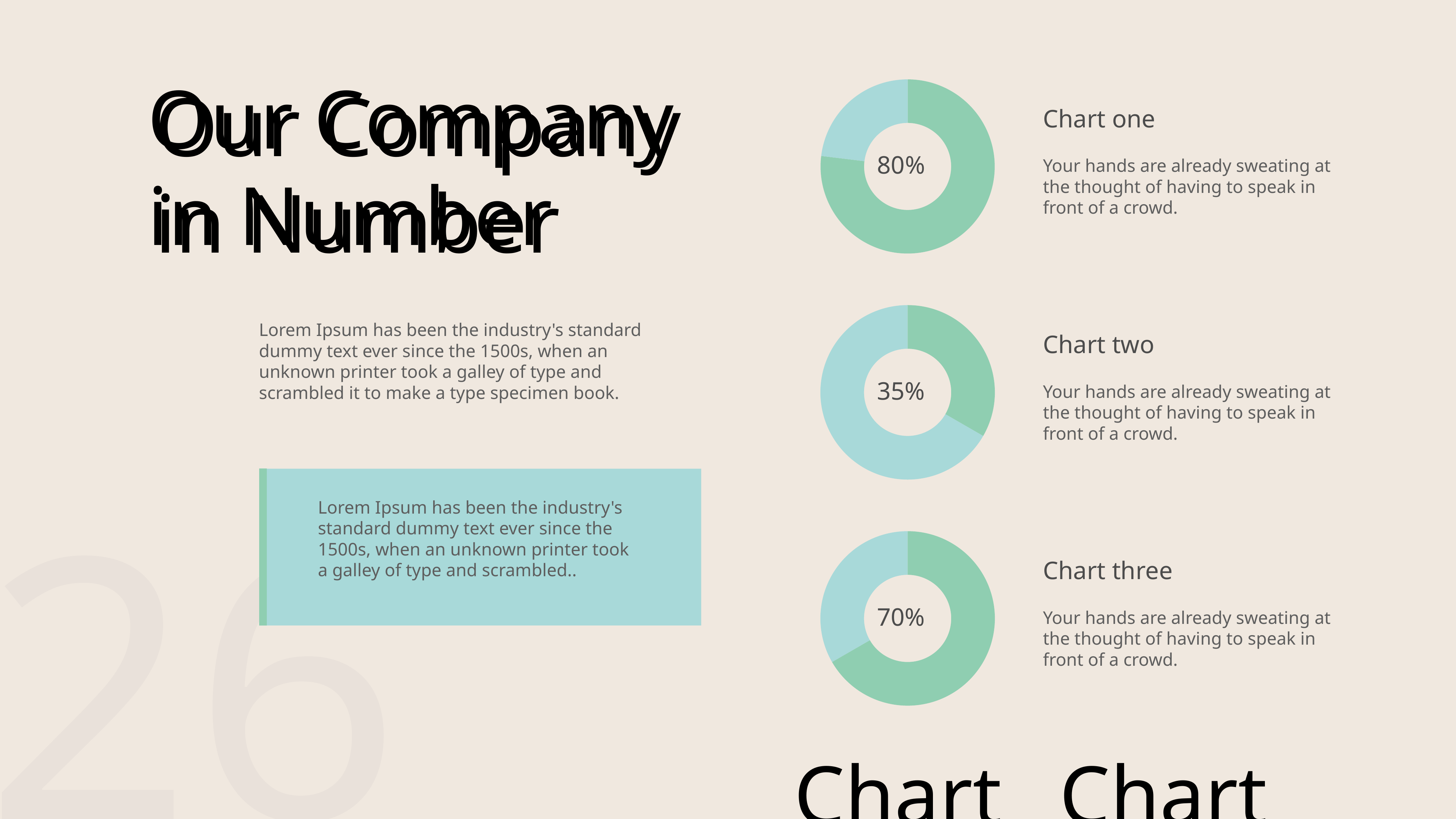
What percentage is shown in the centre of the donut chart labelled Chart two? 35% Which shows a larger percentage, Chart two or Chart three? Chart three Which of the three donut charts shows the highest percentage? Chart one How many donut charts are on the slide? 3 What is the difference between the percentage shown for Chart one and the percentage shown for Chart two? 45% What percentage is shown in the centre of the donut chart labelled Chart one? 80% Which of the three donut charts shows the lowest percentage? Chart two What kind of chart is used for Chart one, Chart two and Chart three? Donut chart What is the title of the slide containing the three donut charts? Our Company in Number What colour is the larger segment of the donut chart labelled Chart one? Green What percentage is shown in the centre of the donut chart labelled Chart three? 70% What is the difference between the percentage shown for Chart one and the percentage shown for Chart three? 10%